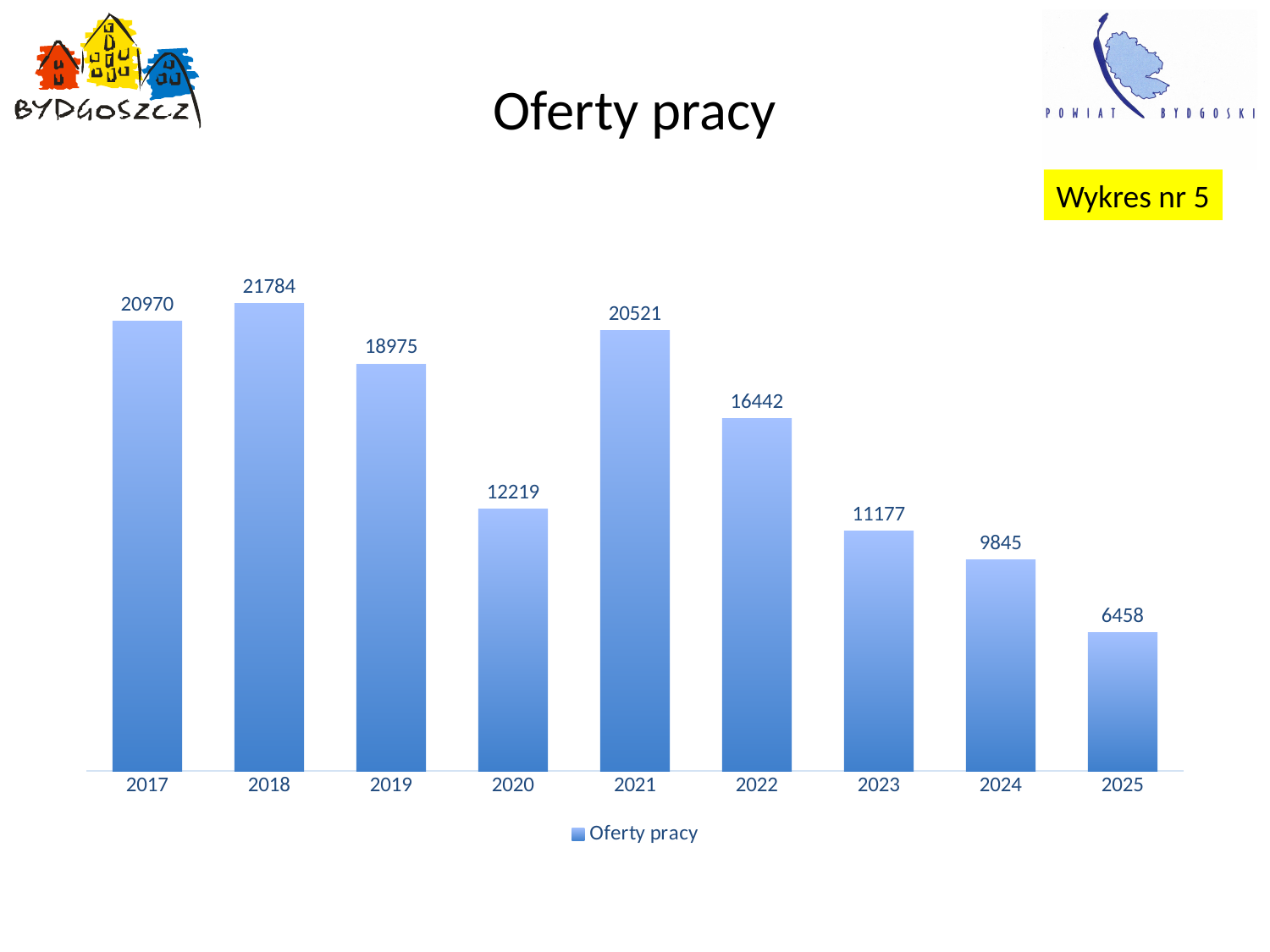
Which is larger, the value for 2019 or the value for 2021? 2021 What is the difference between the values for 2017 and 2025? 14512 What is the value for 2018? 21784 Which year has the lowest value? 2025 How many series does the legend list? 1 Do the values rise or fall from 2021 to 2025? fall What is the value for 2025? 6458 Which year has the highest value? 2018 How many years are shown on the x axis? 9 What is the difference between the values for 2021 and 2022? 4079 What kind of chart is shown? bar chart What is the value for 2020? 12219